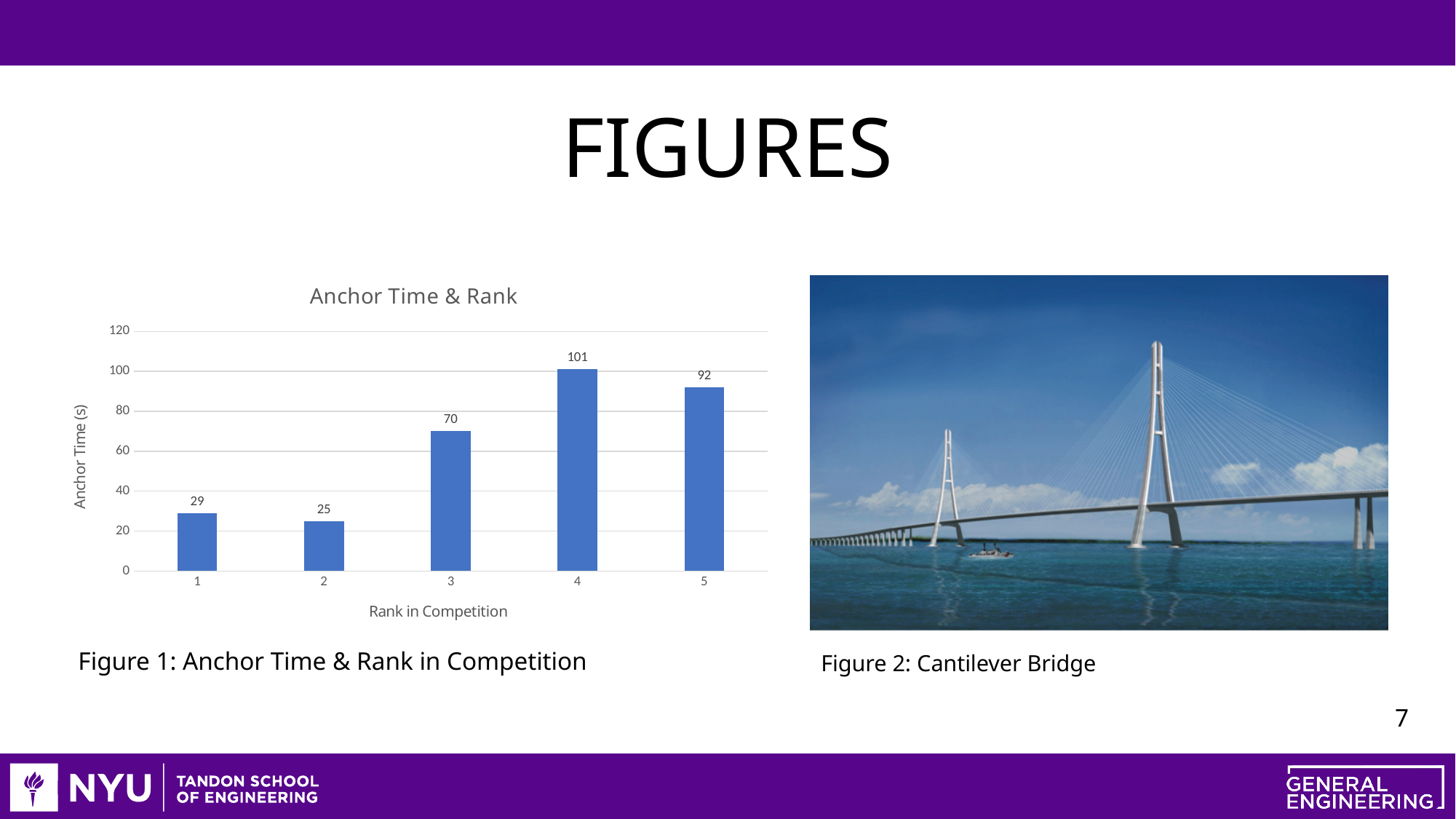
What is the difference in anchor time between rank 3 and rank 2 in the Anchor Time & Rank chart? 45 In the Anchor Time & Rank chart, which has a larger anchor time, rank 1 or rank 3? rank 3 What is the y-axis label of the Anchor Time & Rank chart? Anchor Time (s) How many ranks are shown on the x axis of the Anchor Time & Rank chart? 5 Which rank has the highest anchor time in the Anchor Time & Rank chart? 4 Which rank has the lowest anchor time in the Anchor Time & Rank chart? 2 Is the anchor time for rank 4 greater or less than 100 in the Anchor Time & Rank chart? greater What is the anchor time for rank 1 in the Anchor Time & Rank chart? 29 What is the anchor time for rank 5 in the Anchor Time & Rank chart? 92 What is the anchor time for rank 4 in the Anchor Time & Rank chart? 101 What is the difference in anchor time between rank 4 and rank 5 in the Anchor Time & Rank chart? 9 What kind of chart is the Anchor Time & Rank chart? bar chart